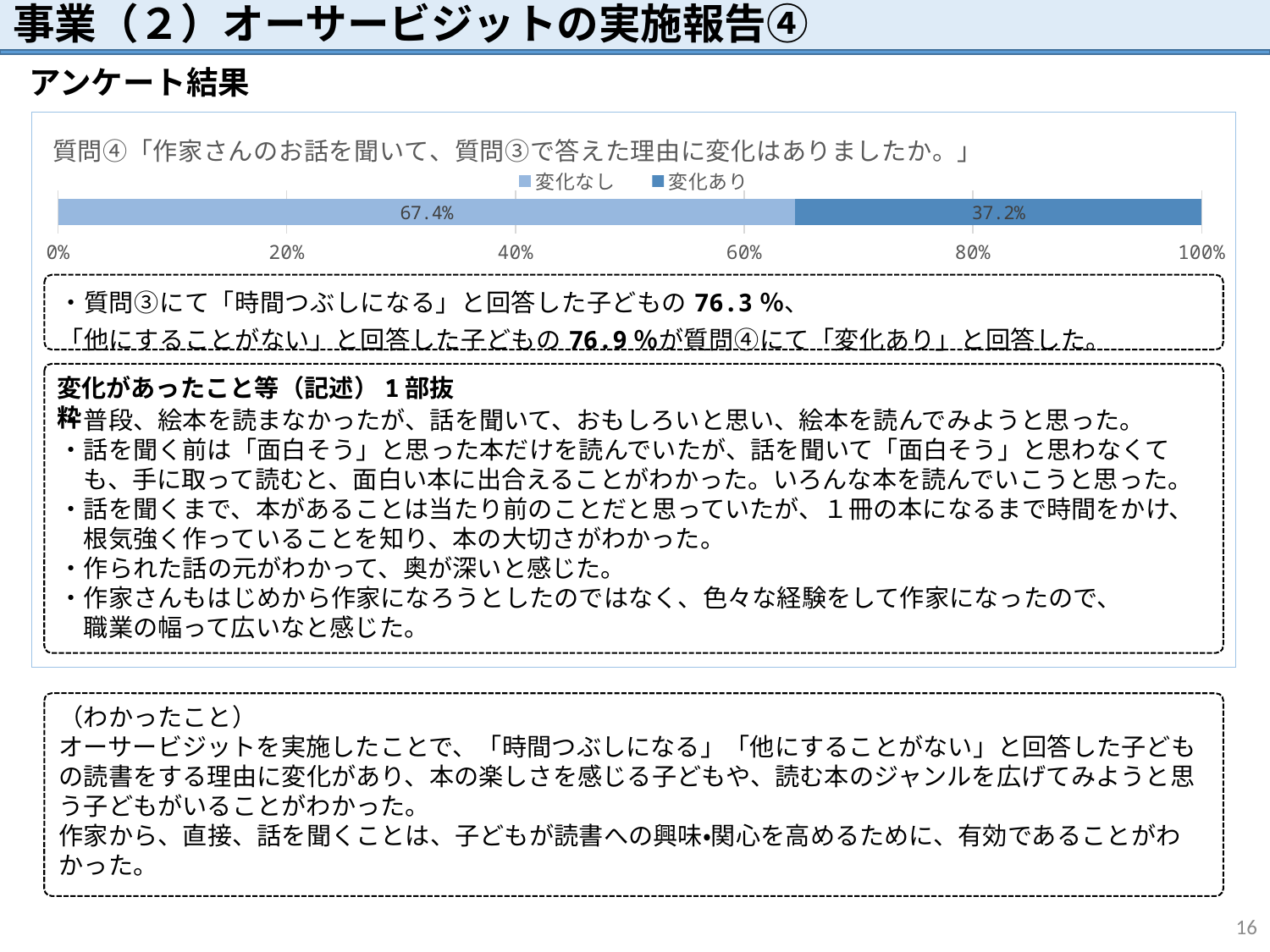
Which series has the larger value, 変化なし or 変化あり? 変化なし What is the value for 変化なし in the chart? 67.4% What is the maximum value shown on the chart's horizontal axis? 100% What is the difference between the values for 変化なし and 変化あり? 30.2% What are the two legend entries of the chart? 変化なし, 変化あり What kind of chart is shown on the slide? Stacked bar chart Which series has the smallest value in the chart? 変化あり Which series has the largest value in the chart? 変化なし Is the value for 変化あり greater or less than 50%? less How many series does the legend list? 2 What is the value for 変化あり in the chart? 37.2% Is the value for 変化なし greater or less than 60%? greater